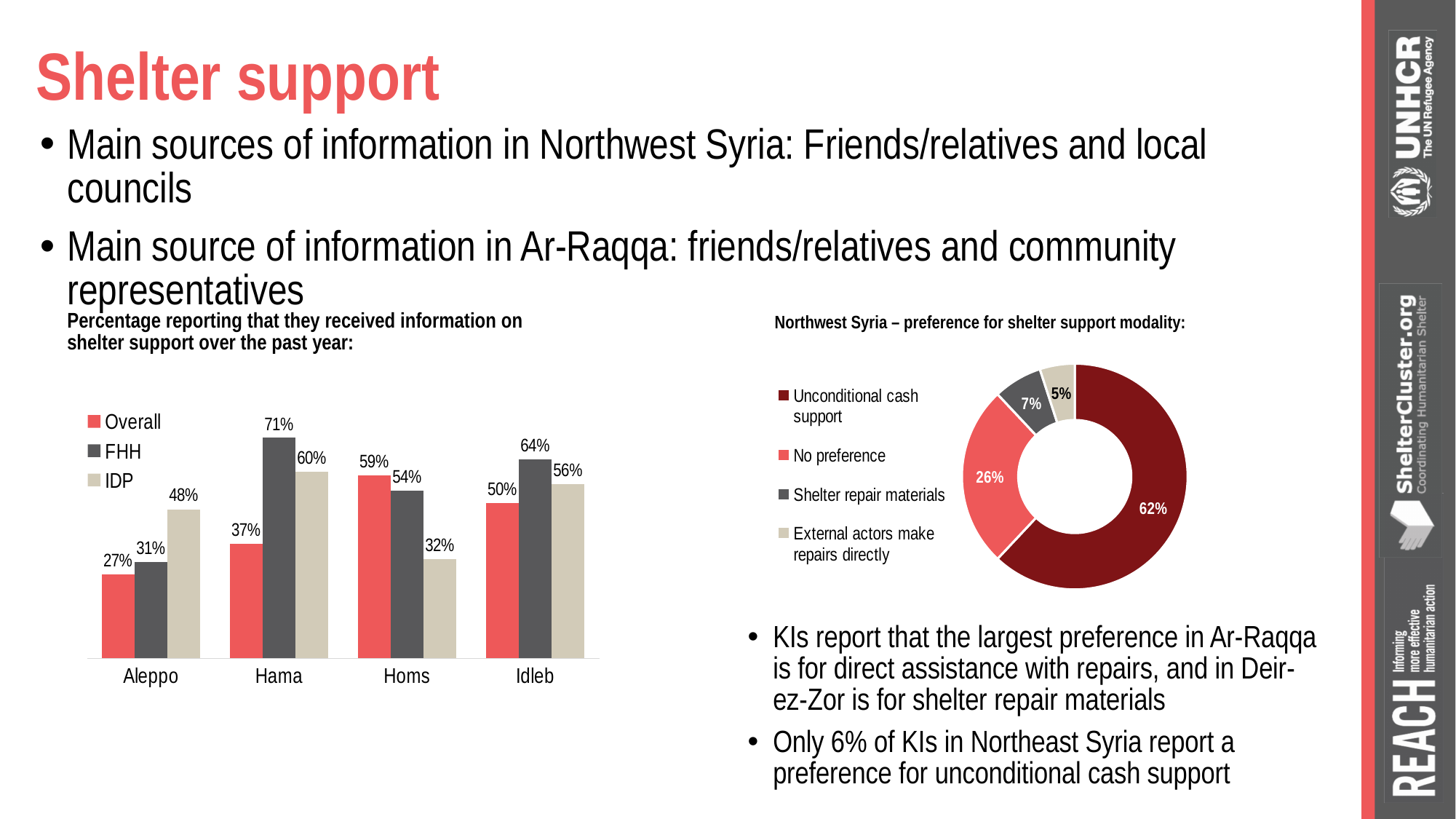
In the bar chart on the left, which governorate has the highest FHH value? Hama In the bar chart on the left, which is larger: the Overall value for Homs or the Overall value for Idleb? Homs In the bar chart on the left, what is the Overall value for Hama? 37% How many governorates are shown on the x axis of the bar chart on the left? 4 In the bar chart on the left, what is the FHH value for Idleb? 64% How many series does the legend of the bar chart on the left list? 3 In the bar chart on the left, which governorate has the lowest Overall value? Aleppo In the bar chart on the left, what is the difference between the FHH and IDP values for Homs? 22% In the doughnut chart on the right, what share is Unconditional cash support? 62% What kind of chart is the chart on the left of the slide? Bar chart In the doughnut chart on the right, which category has the smallest share? External actors make repairs directly In the bar chart on the left, what is the IDP value for Aleppo? 48%